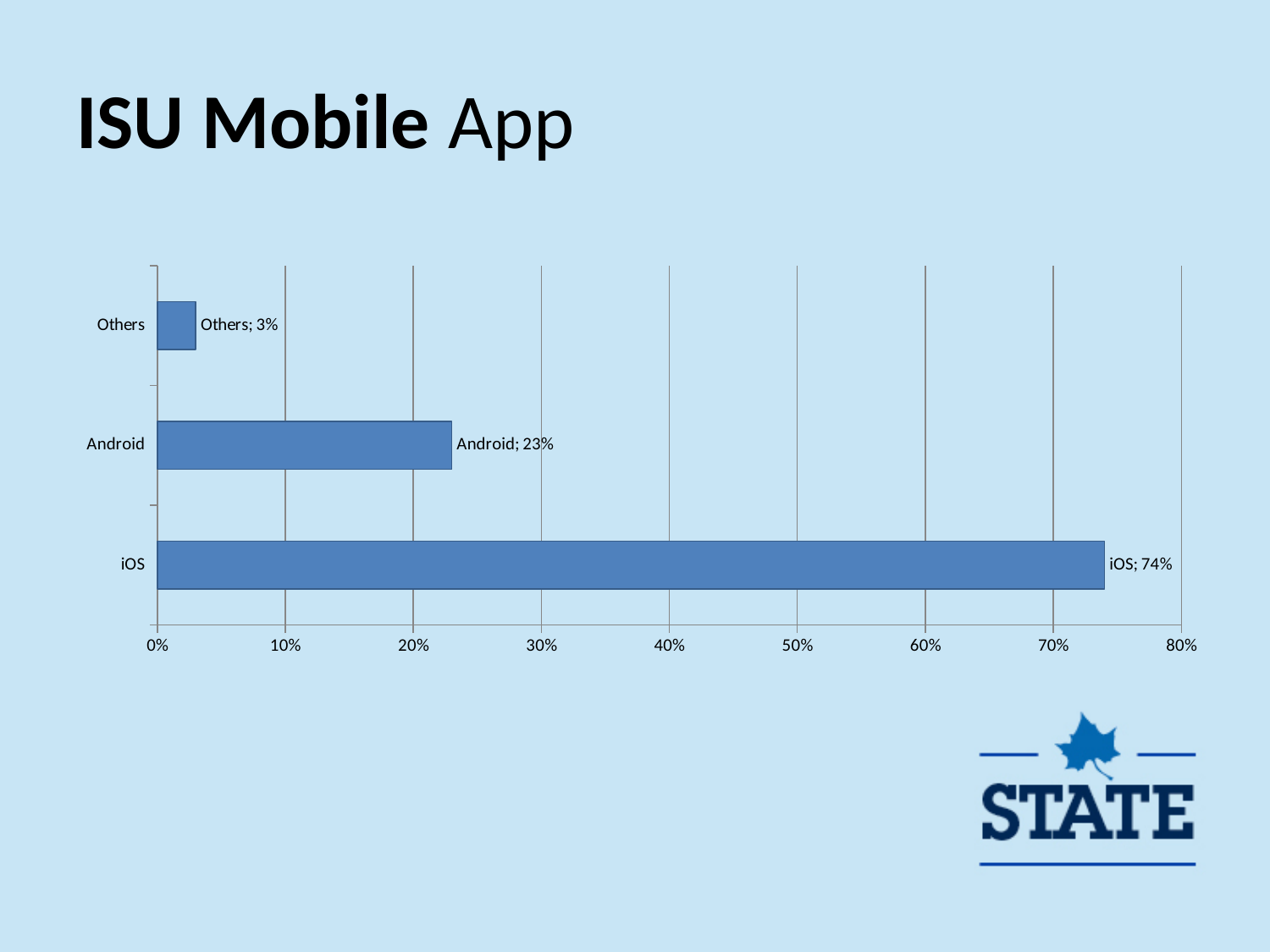
Is the value for iOS greater or less than 70%? greater What kind of chart is shown on the slide? bar chart Which is larger, the value for Android or the value for Others? Android How many categories are shown in the chart? 3 Which category has the highest value? iOS What is the difference between the Android and Others values? 20% What is the maximum value shown on the horizontal axis? 80% What is the value for Android? 23% What is the value for iOS? 74% Which category has the lowest value? Others What is the value for Others? 3% What is the difference between the iOS and Android values? 51%